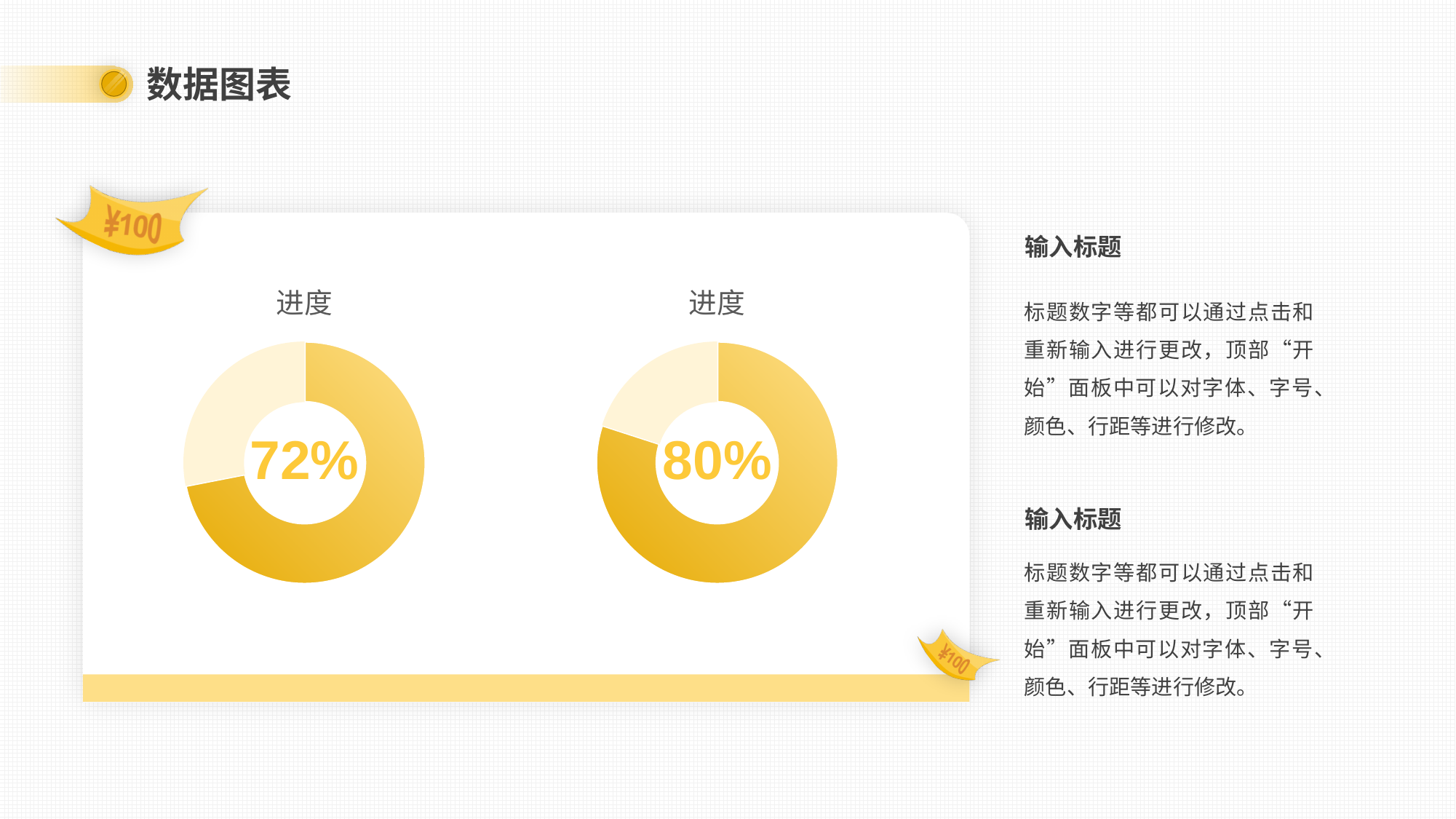
In the right chart, what share of the ring is not filled by the 80% segment? 20% What value is shown in the centre of the right doughnut chart? 80% Which chart shows the lower percentage, the left one or the right one? the left one How many charts are on the slide? 2 Which chart shows the higher percentage, the left one or the right one? the right one What value is shown in the centre of the left doughnut chart? 72% What is the title of the right chart? 进度 What is the title of the left chart? 进度 What is the difference in percentage points between the right chart's value and the left chart's value? 8 In the left chart, what share of the ring is not filled by the 72% segment? 28% What kind of chart is used on this slide? doughnut chart